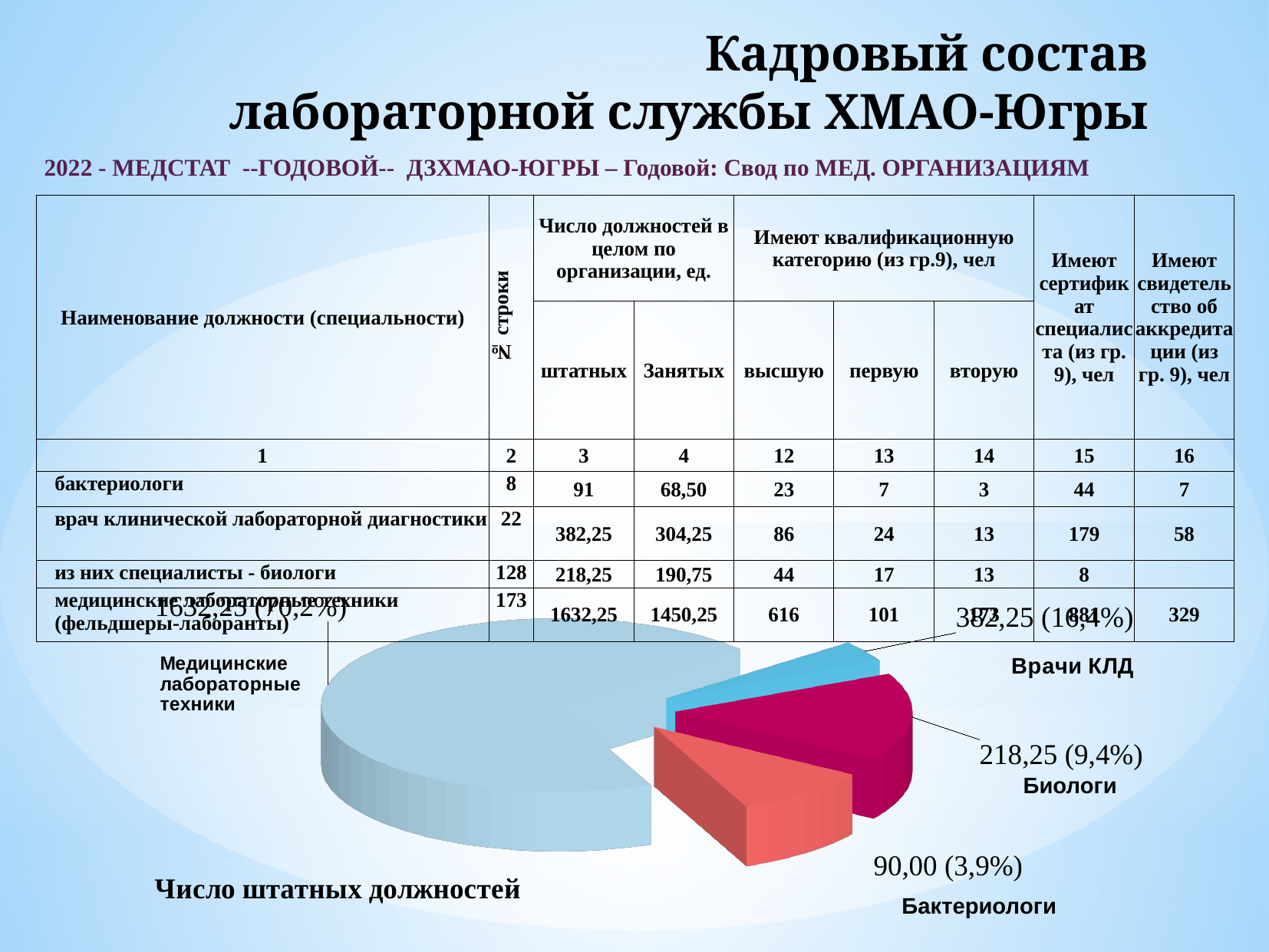
What value is shown for Медицинские лабораторные техники in the pie chart? 1632,25 What is the title of the pie chart? Число штатных должностей What is the difference between the values for Врачи КЛД and Биологи in the pie chart? 164,00 What value is shown for Бактериологи in the pie chart? 90,00 Which category has the largest slice in the pie chart? Медицинские лабораторные техники What share of the pie does Врачи КЛД have? 16,4% What share of the pie does Медицинские лабораторные техники have? 70,2% What kind of chart is shown on the slide? pie chart Which category has the smallest slice in the pie chart? Бактериологи How many slices does the pie chart have? 4 What value is shown for Биологи in the pie chart? 218,25 Which is larger in the pie chart, Биологи or Врачи КЛД? Врачи КЛД